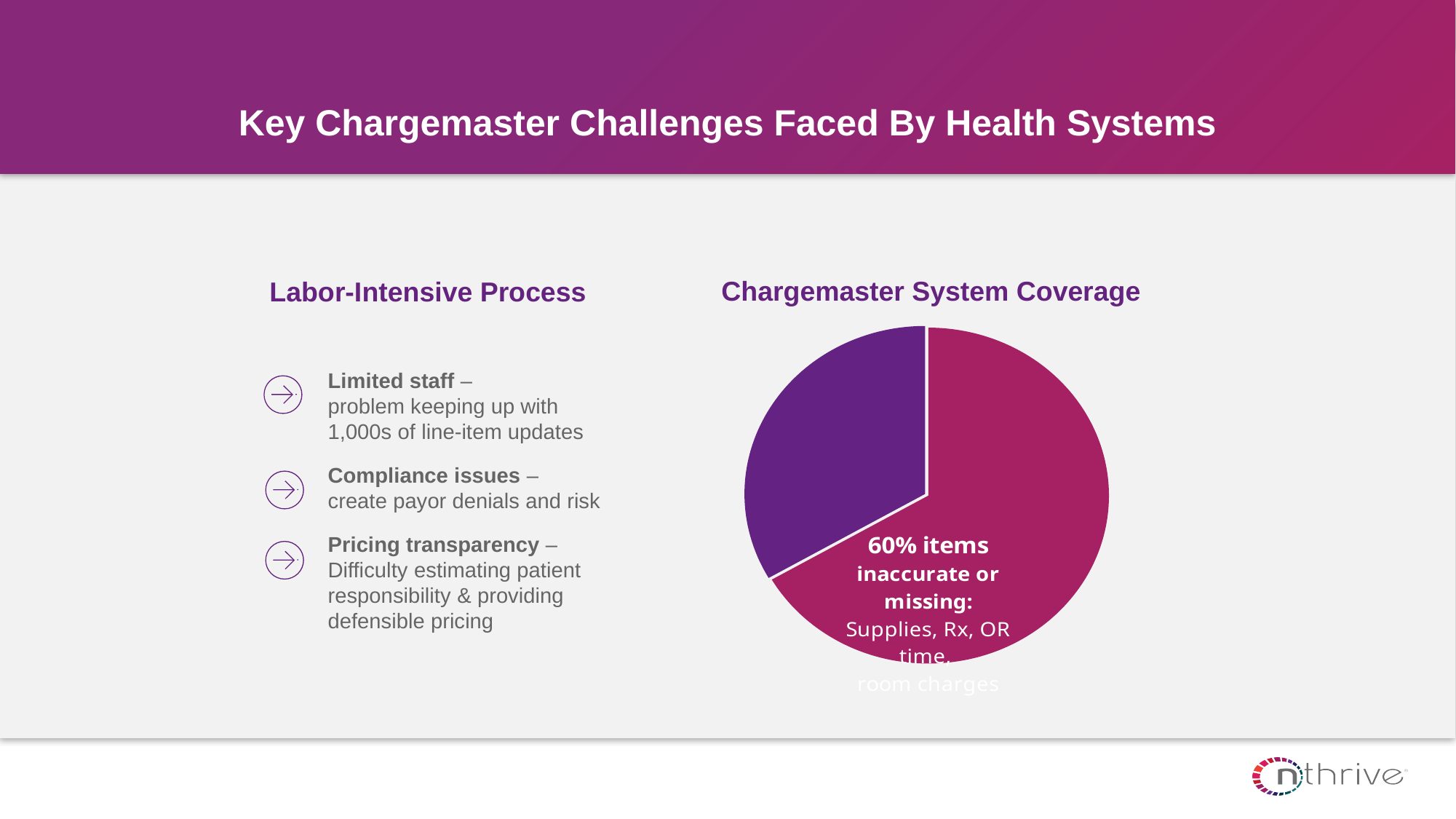
What is the title shown above the pie chart? Chargemaster System Coverage Is the share of the slice labeled "items inaccurate or missing" greater or less than 50%? greater What percentage of items does the labeled slice of the pie chart say are inaccurate or missing? 60% What kind of chart is shown under the heading "Chargemaster System Coverage"? Pie chart Which slice of the Chargemaster System Coverage pie is the largest? The slice labeled "60% items inaccurate or missing" Which slice of the pie chart is larger, the magenta slice or the purple slice? The magenta slice How many slices does the Chargemaster System Coverage pie chart have? 2 Which items are listed in the 60% slice as inaccurate or missing? Supplies, Rx, OR time, room charges